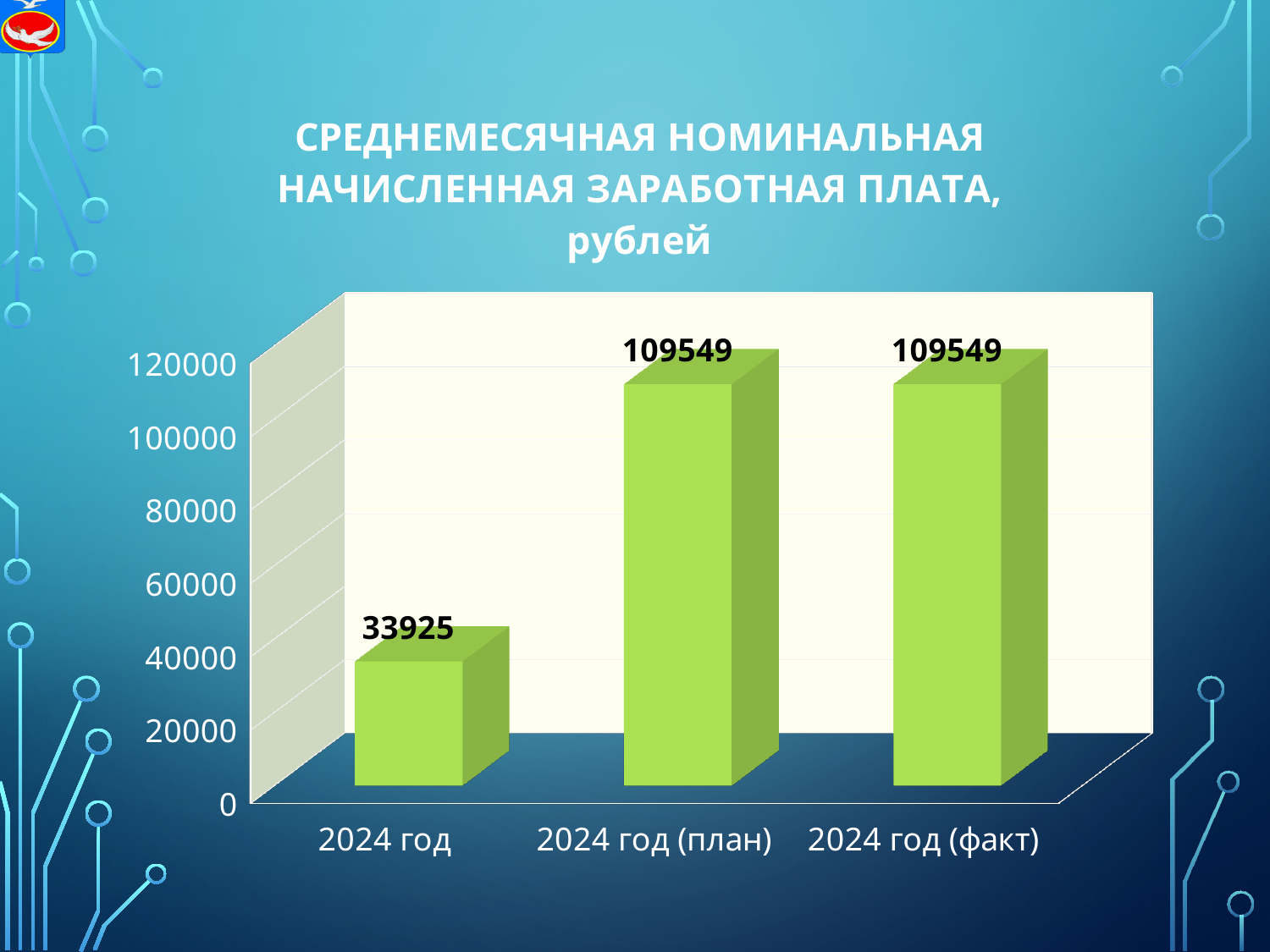
What is the difference between the values for 2024 год (план) and 2024 год (факт)? 0 What is the value for 2024 год (план)? 109549 Which category has the lowest value? 2024 год What is the difference between the values for 2024 год (план) and 2024 год? 75624 What unit is named in the chart title? рублей What kind of chart is shown on the slide? bar chart What is the value for 2024 год (факт)? 109549 Which is larger, the value for 2024 год or the value for 2024 год (факт)? 2024 год (факт) Is the value for 2024 год (план) greater or less than 100000? greater Is the value for 2024 год greater or less than 40000? less What is the value for 2024 год? 33925 How many categories are shown on the x axis? 3